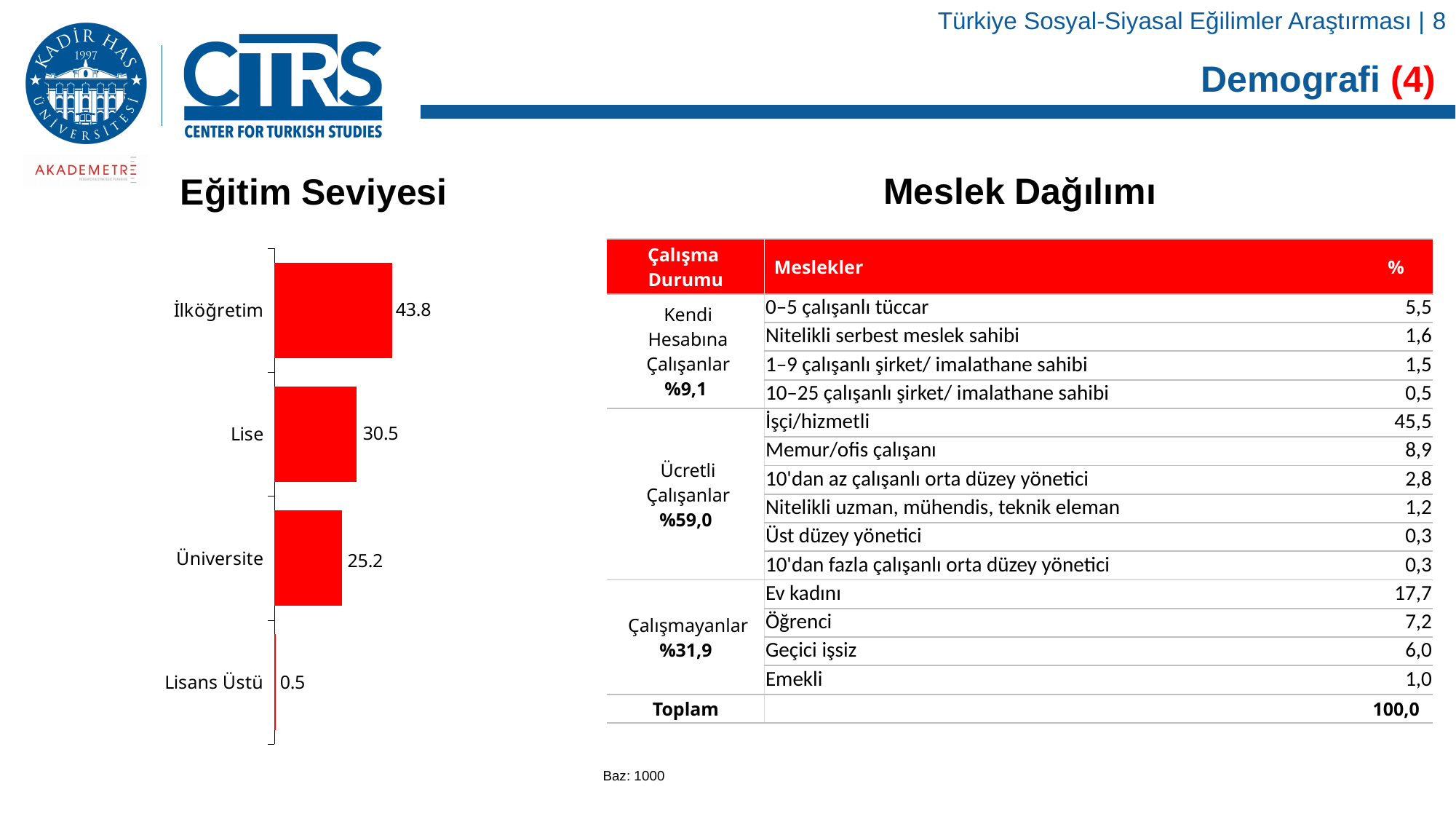
In the Eğitim Seviyesi chart, what is the value for Üniversite? 25.2 In the Eğitim Seviyesi chart, what is the value for Lise? 30.5 In the Eğitim Seviyesi chart, do the values rise or fall going from the top category to the bottom category? Fall In the Eğitim Seviyesi chart, which category has the highest value? İlköğretim In the Eğitim Seviyesi chart, what is the value for İlköğretim? 43.8 In the Eğitim Seviyesi chart, which category has the lowest value? Lisans Üstü What kind of chart is the Eğitim Seviyesi chart? Bar chart In the Eğitim Seviyesi chart, what is the value for Lisans Üstü? 0.5 In the Eğitim Seviyesi chart, what is the difference between the values for İlköğretim and Lise? 13.3 In the Eğitim Seviyesi chart, which is larger, the value for Lise or the value for Üniversite? Lise In the Eğitim Seviyesi chart, what is the difference between the values for Lise and Üniversite? 5.3 How many categories are shown in the Eğitim Seviyesi chart? 4